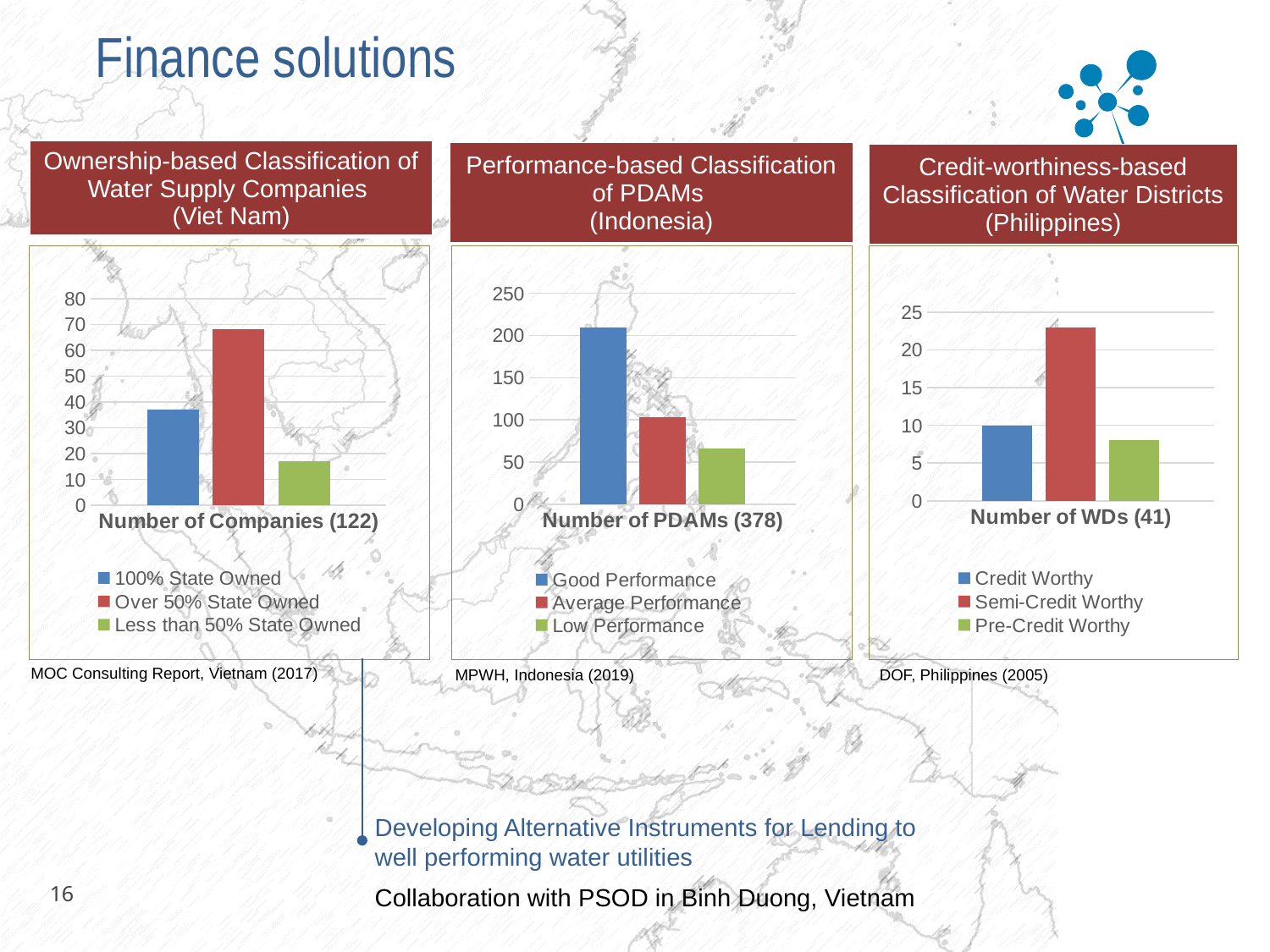
In the Viet Nam chart, which series has the highest value? Over 50% State Owned In the Credit-worthiness-based Classification of Water Districts (Philippines) chart, which series has the highest value? Semi-Credit Worthy In the Indonesia chart, is the value for Low Performance greater or less than 100? less In the Indonesia chart, is the value for Good Performance greater or less than 200? greater In the Indonesia chart, which is larger, Average Performance or Low Performance? Average Performance What is the x-axis category label on the Philippines chart? Number of WDs (41) What kind of chart is the Ownership-based Classification of Water Supply Companies (Viet Nam) chart? bar chart In the Philippines chart, is the value for Semi-Credit Worthy greater or less than 20? greater In the Viet Nam chart, which series has the lowest value? Less than 50% State Owned In the Performance-based Classification of PDAMs (Indonesia) chart, which series has the highest value? Good Performance How many series does the legend of the Viet Nam chart list? 3